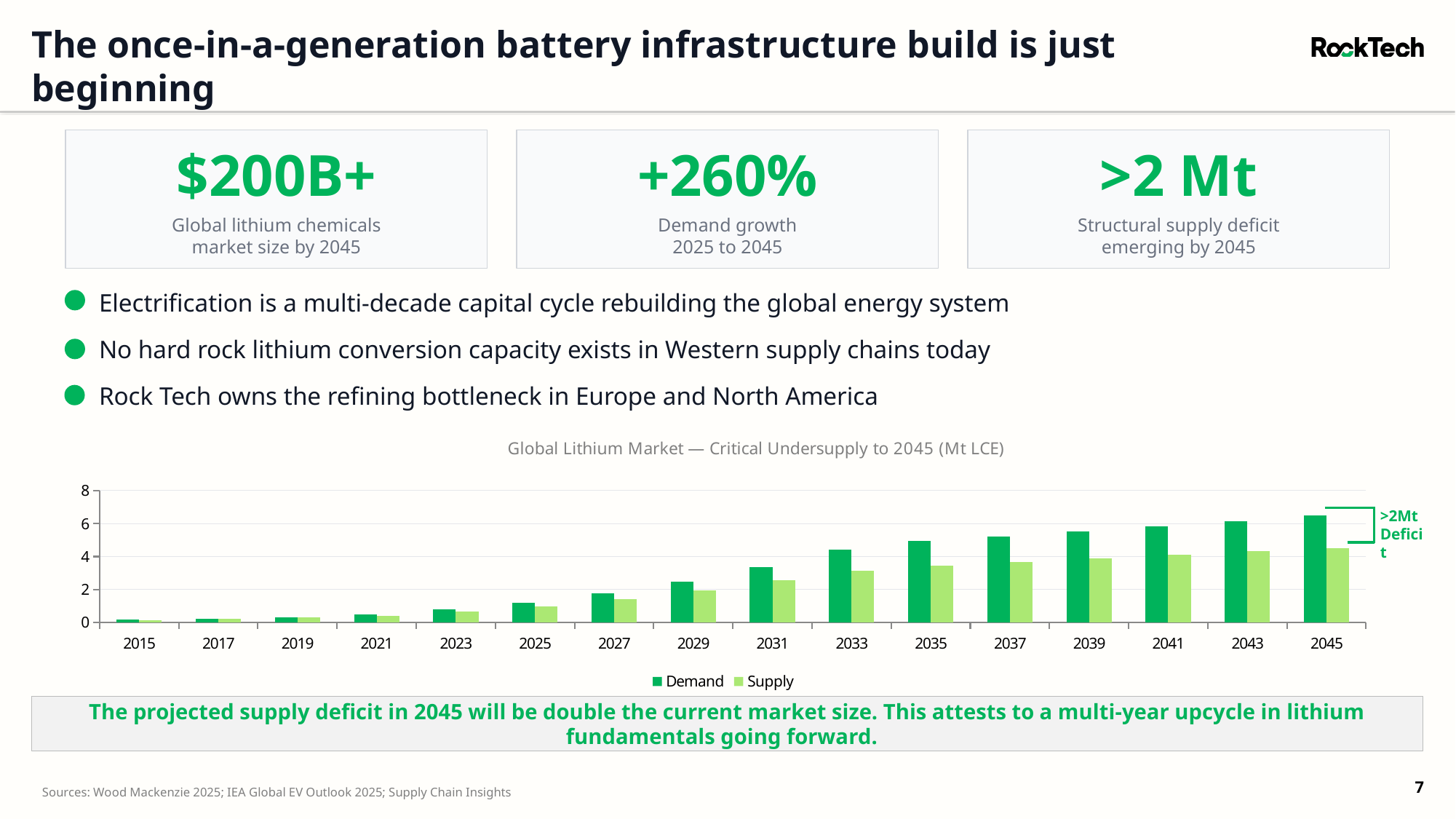
Is the Supply value for 2035 greater or less than 4? less How many series does the chart legend list? 2 What is the title of the chart? Global Lithium Market — Critical Undersupply to 2045 (Mt LCE) Is the Demand value for 2025 greater or less than 2? less What kind of chart is shown on the slide? Bar chart Is the Demand value for 2045 greater or less than 6? greater In which year is the Demand bar lowest? 2015 How many years are shown on the x axis of the chart? 16 What are the two series named in the chart legend? Demand and Supply In which year is the Demand bar highest? 2045 Do the Demand values rise or fall from 2015 to 2045? Rise In 2045, which is larger, Demand or Supply? Demand